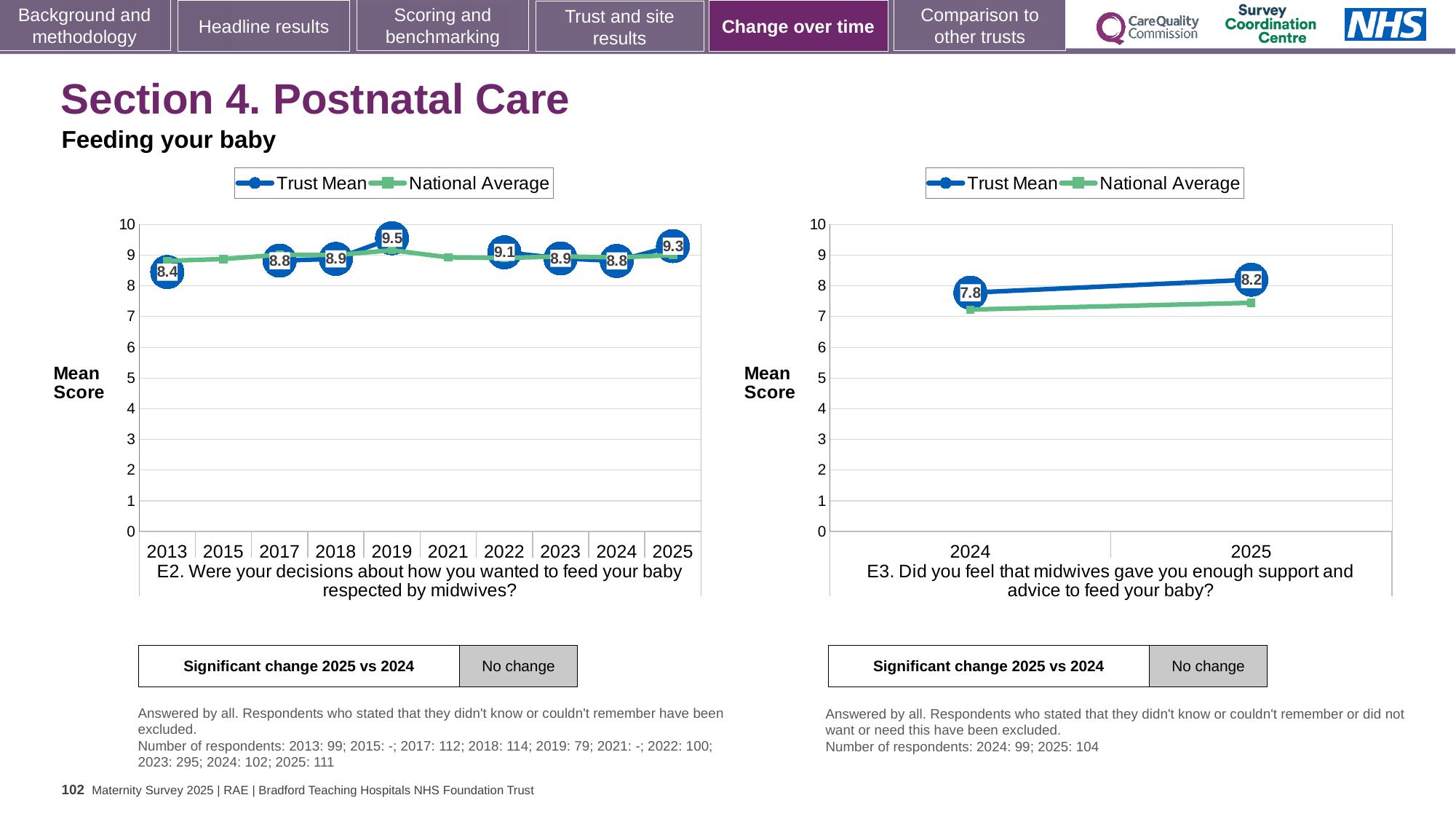
In the E2 chart on the left, how many years are shown on the x axis? 10 In the E2 chart on the left, which year has the lowest Trust Mean score? 2013 In the E2 chart on the left, what is the Trust Mean score for 2013? 8.4 In the E3 chart on the right, how many series does the legend list? 2 In the E3 chart on the right, what is the Trust Mean score for 2025? 8.2 In the E2 chart on the left, what is the Trust Mean score for 2025? 9.3 In the E3 chart on the right, is the National Average value for 2024 greater or less than 8? less In the E2 chart on the left, what is the difference between the Trust Mean scores for 2025 and 2024? 0.5 What type of chart is the E2 chart on the left? line chart In the E3 chart on the right, does the Trust Mean rise or fall from 2024 to 2025? rise In the E2 chart on the left, which year has the highest Trust Mean score? 2019 In the E3 chart on the right, what is the Trust Mean score for 2024? 7.8